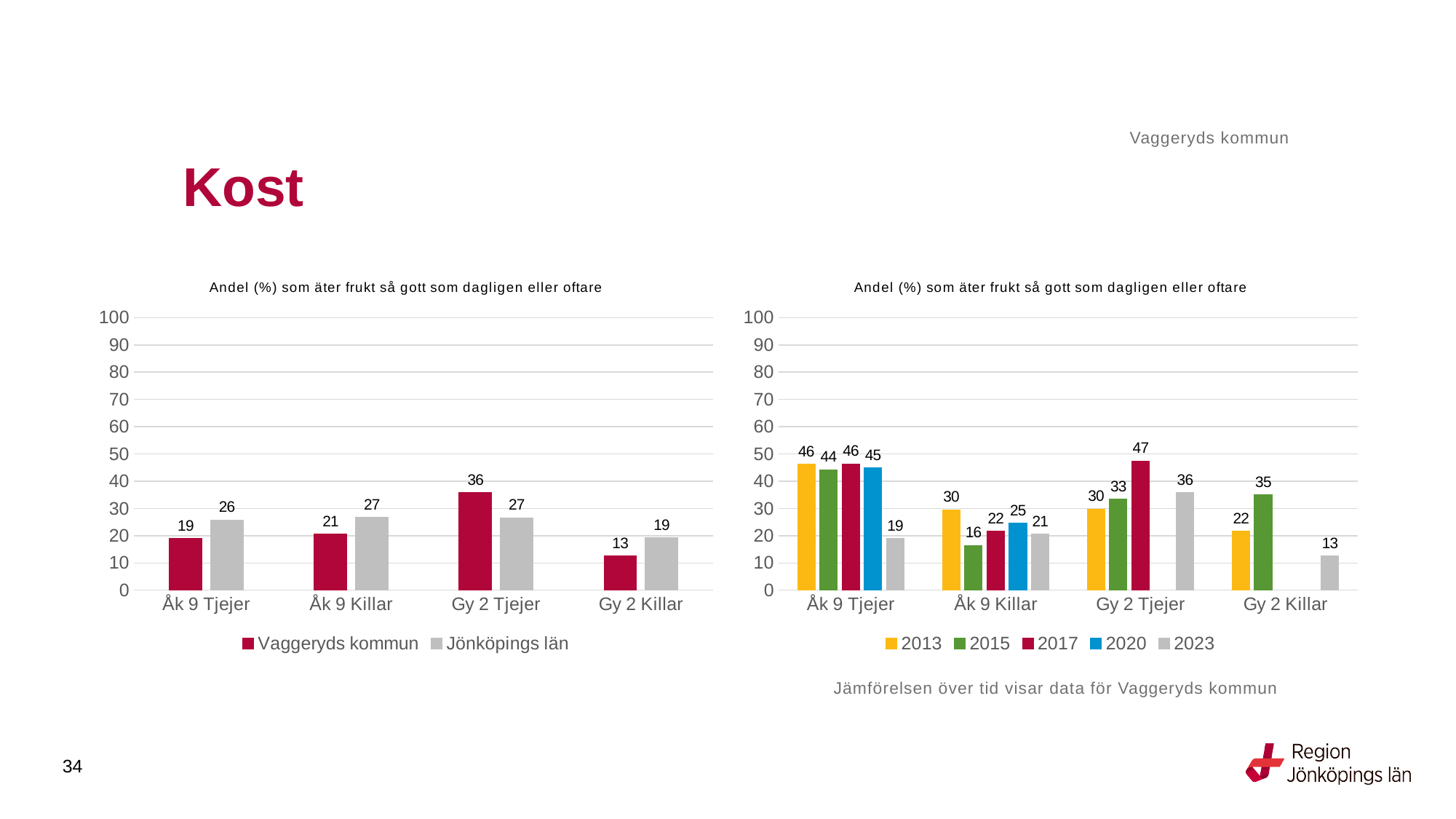
In the left chart, what is the value for Jönköpings län for Åk 9 Killar? 27 In the left chart, what is the difference between Jönköpings län and Vaggeryds kommun for Åk 9 Tjejer? 7 In the left chart, which category has the lowest value for Vaggeryds kommun? Gy 2 Killar In the left chart, which is larger for Gy 2 Tjejer: Vaggeryds kommun or Jönköpings län? Vaggeryds kommun In the right chart, what is the value for 2023 for Åk 9 Tjejer? 19 What type of chart is the right chart? Bar chart How many series does the legend of the left chart list? 2 In the right chart, what is the value for 2017 for Gy 2 Tjejer? 47 In the right chart, which year has the lowest value for Åk 9 Killar? 2015 How many series does the legend of the right chart list? 5 In the right chart, what is the difference between 2015 and 2023 for Gy 2 Killar? 22 In the left chart, what is the value for Vaggeryds kommun for Gy 2 Tjejer? 36